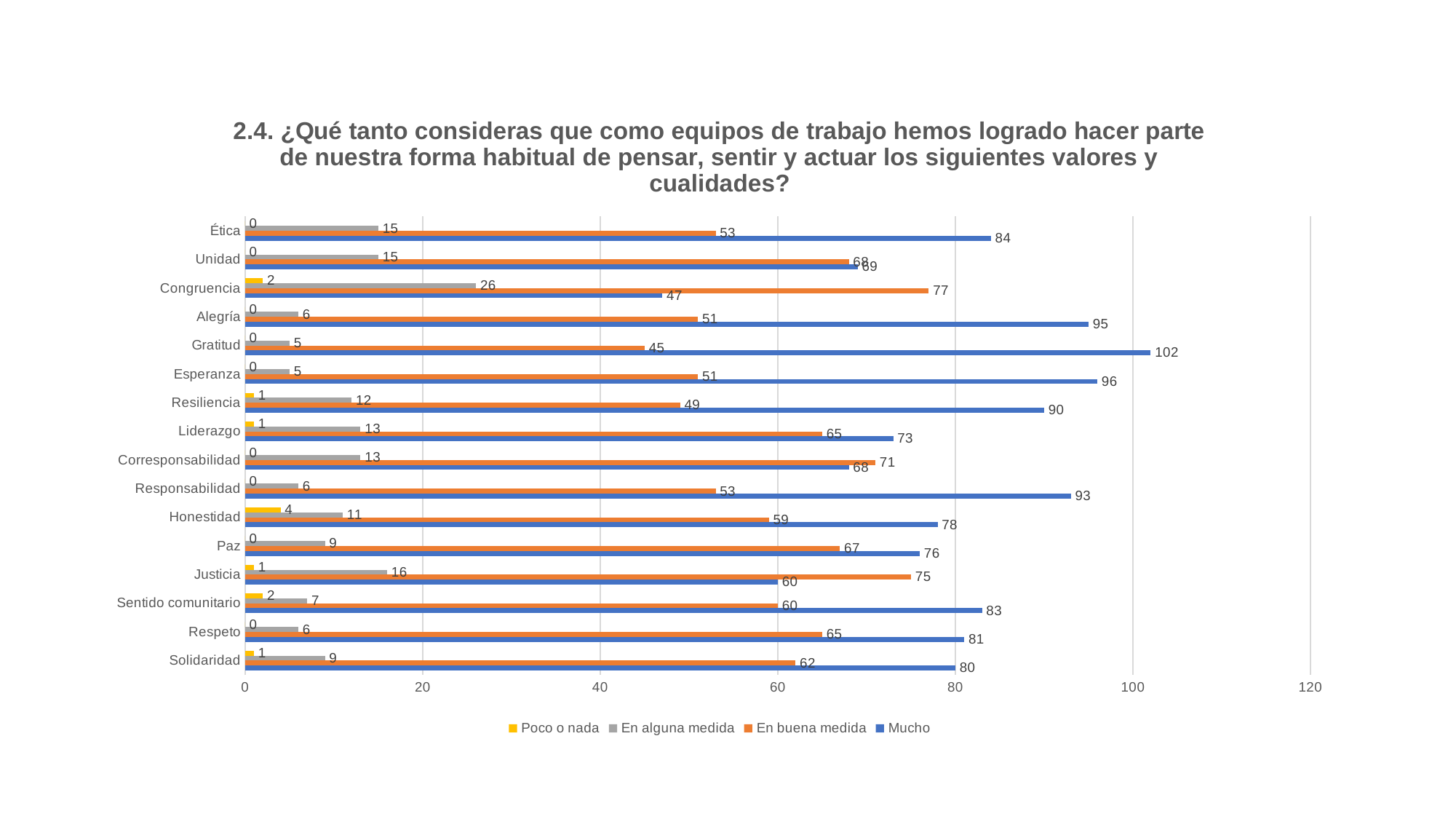
Which category has the highest value in the "Mucho" series? Gratitud Which category has the highest value in the "En alguna medida" series? Congruencia What is the value of the "Mucho" series for Gratitud? 102 How many categories are shown on the vertical axis? 16 Which category has the lowest value in the "Mucho" series? Congruencia What is the difference between the "Mucho" values for Alegría and Ética? 11 How many series does the legend list? 4 What type of chart is shown on the slide? Bar chart What is the value of the "En alguna medida" series for Justicia? 16 Which series is shown in blue in the legend? Mucho For Justicia, which is larger: the "En buena medida" value or the "Mucho" value? En buena medida What is the value of the "En buena medida" series for Congruencia? 77